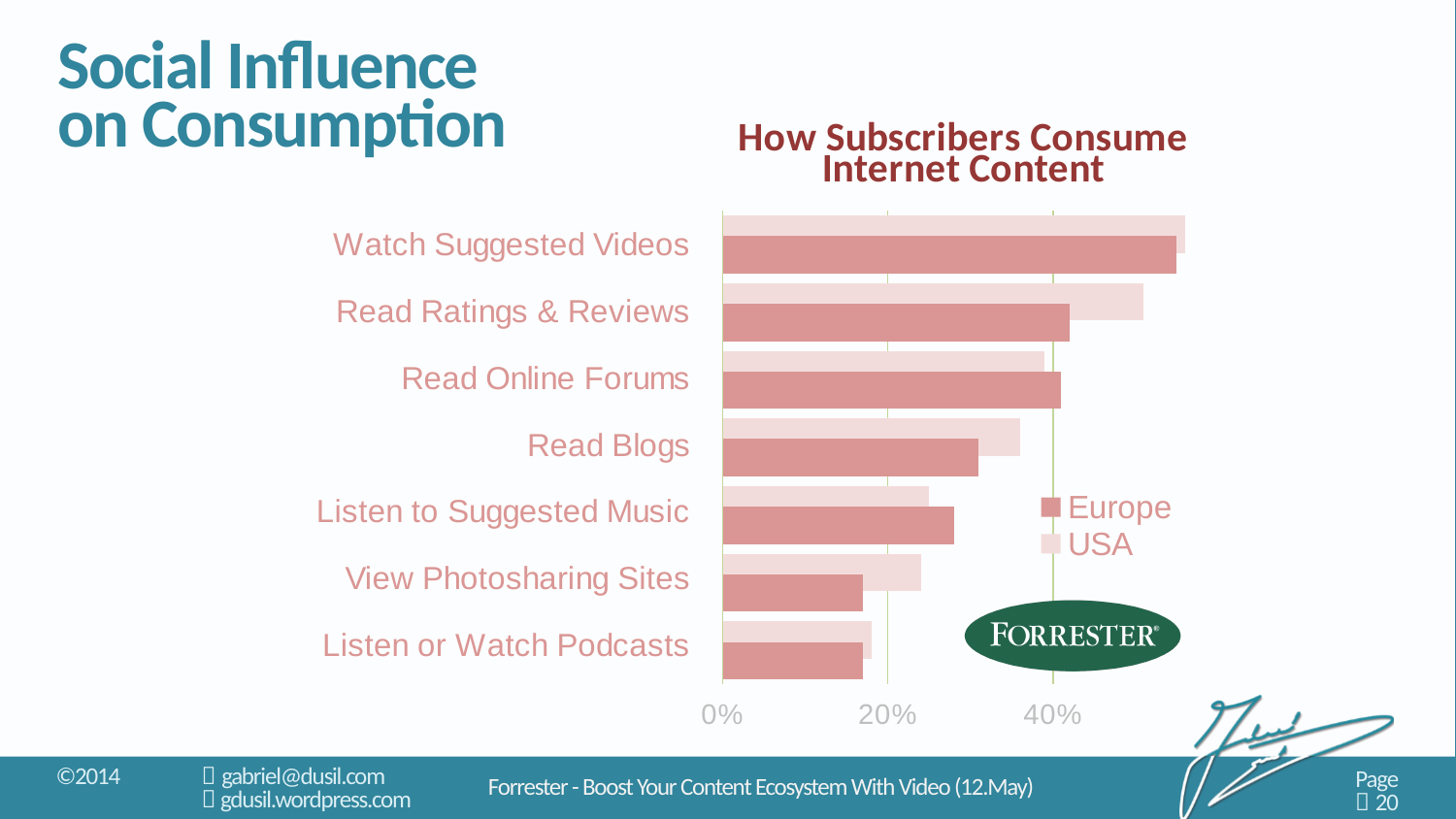
Which category has the lowest value for the USA series? Listen or Watch Podcasts Which category has the highest value for the USA series? Watch Suggested Videos Which category has the highest value for the Europe series? Watch Suggested Videos Is the USA value for Read Blogs greater or less than 40%? less Is the Europe value for View Photosharing Sites greater or less than 20%? less What kind of chart is shown on the slide? bar chart Which legend entry is shown in the darker shade of red? Europe How many series does the chart's legend list? 2 How many categories are plotted on the chart? 7 For Read Ratings & Reviews, which series has the larger value, Europe or USA? USA What is the title of the chart? How Subscribers Consume Internet Content Is the Europe value for Watch Suggested Videos greater or less than 40%? greater